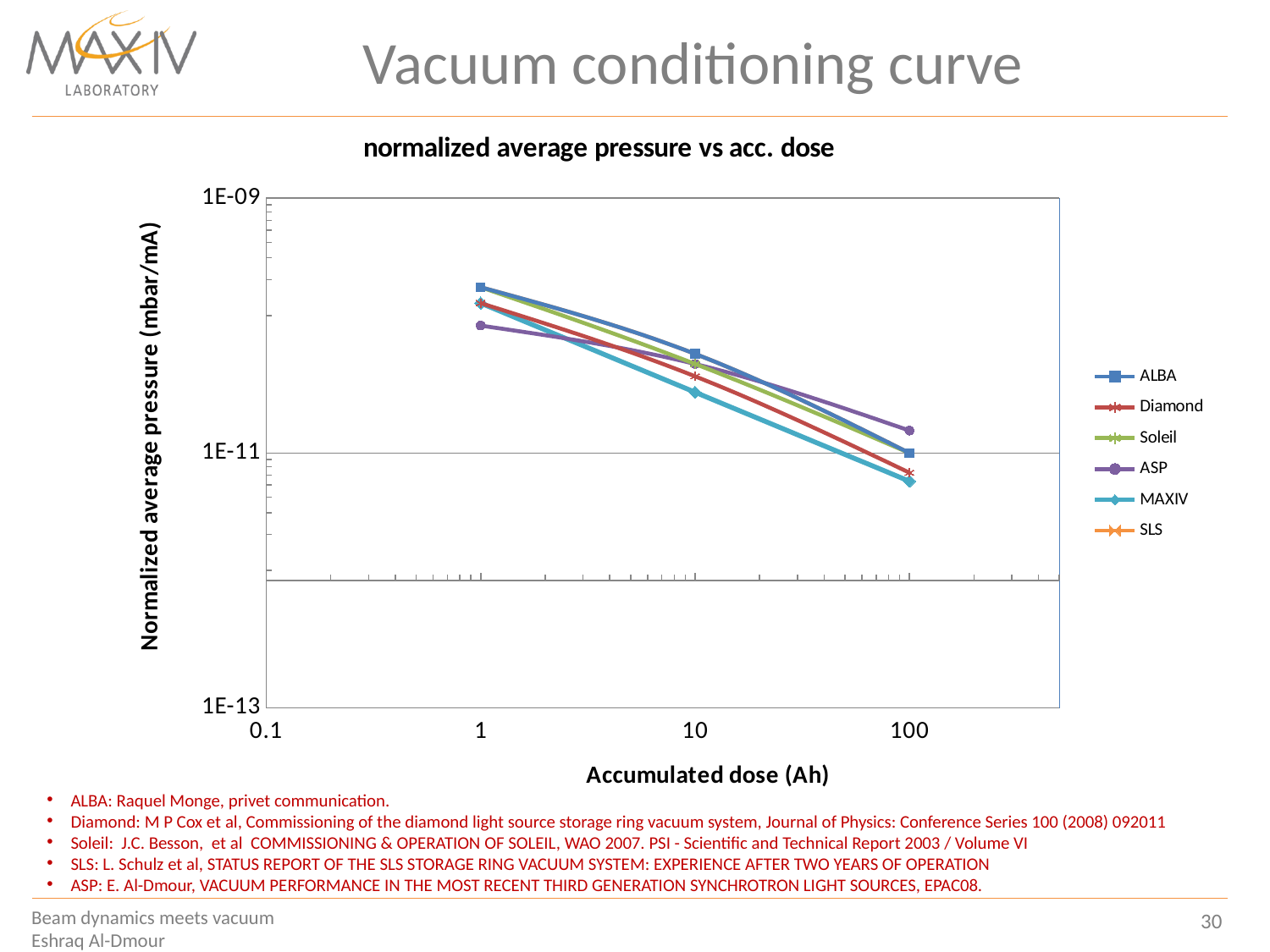
What kind of chart is shown on the slide? line chart At an accumulated dose of 100 Ah, which is larger, the value for ASP or the value for MAXIV? ASP How many series does the legend list? 6 Which series has the highest normalized average pressure at an accumulated dose of 100 Ah? ASP What is the title of the chart? normalized average pressure vs acc. dose How many accumulated dose points are plotted for the ALBA series? 3 Which series has the highest normalized average pressure at an accumulated dose of 1 Ah? ALBA Is the value for MAXIV at 100 Ah greater or less than 1E-11? less Is the value for ASP at 100 Ah greater or less than 1E-11? greater Does the normalized average pressure rise or fall as the accumulated dose increases? fall What is the label of the x axis? Accumulated dose (Ah) Which series has the lowest normalized average pressure at an accumulated dose of 1 Ah? ASP